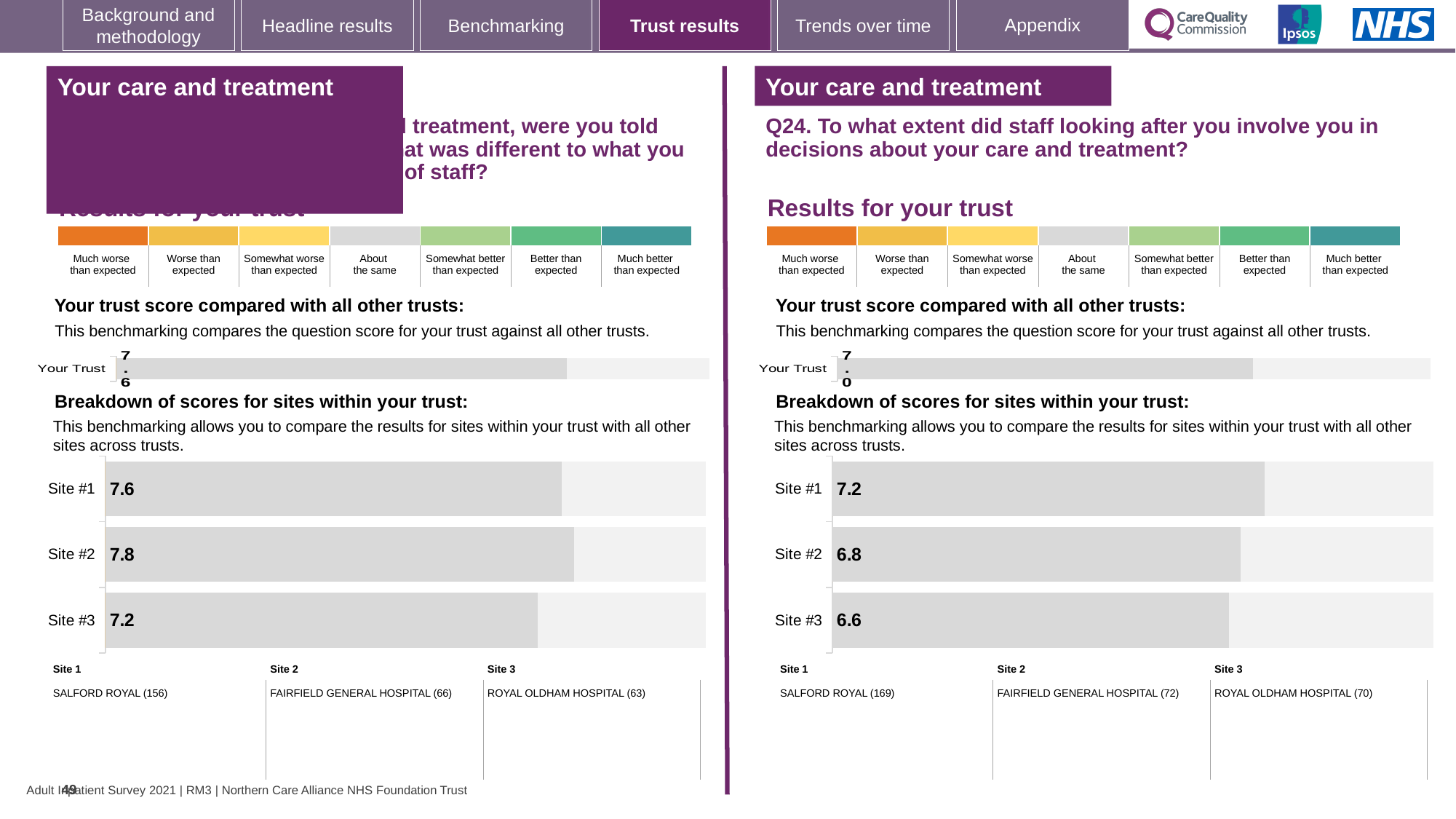
How many sites are shown in the site breakdown chart on the right panel (Q24)? 3 What type of chart is used for the site breakdown on the left panel? Bar chart On the left panel, what is the 'Your Trust' score shown in the trust benchmarking bar? 7.6 On the right panel (Q24) site breakdown chart, is the score for Site #2 or Site #3 larger? Site #2 On the right panel (Q24) site breakdown chart, what is the difference between the scores for Site #1 and Site #3? 0.6 On the left panel's site breakdown chart, what is the difference between the scores for Site #2 and Site #3? 0.6 On the right panel (Q24) site breakdown chart, which site has the highest score? Site #1 On the left panel's site breakdown chart, what is the score for Site #2? 7.8 On the right panel (Q24) site breakdown chart, what is the score for Site #3? 6.6 On the left panel's site breakdown chart, which site has the highest score? Site #2 On the right panel (Q24) site breakdown chart, what is the score for Site #1? 7.2 On the left panel's site breakdown chart, which site has the lowest score? Site #3